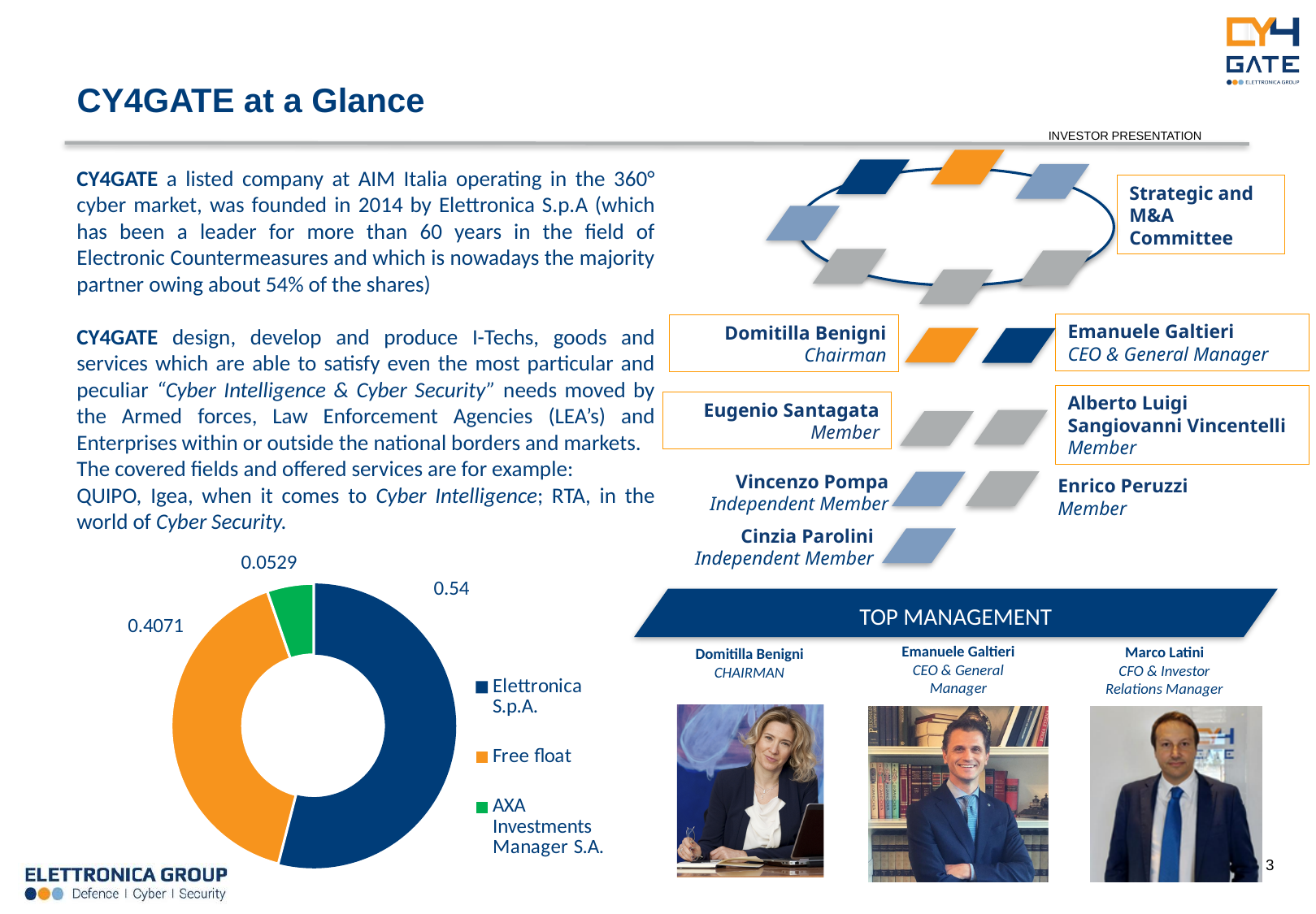
How many slices does the donut chart have? 3 Which is larger in the donut chart, Free float or AXA Investments Manager S.A.? Free float What kind of chart is shown on the slide? Donut (pie) chart What is the value shown for AXA Investments Manager S.A. in the donut chart? 0.0529 Which shareholder has the largest slice in the donut chart? Elettronica S.p.A. How many entries does the legend of the donut chart list? 3 Which shareholder has the smallest slice in the donut chart? AXA Investments Manager S.A. What is the value shown for Elettronica S.p.A. in the donut chart? 0.54 What colour is the AXA Investments Manager S.A. slice in the donut chart? Green What colour is the Free float slice in the donut chart? Orange What is the value shown for Free float in the donut chart? 0.4071 What is the difference between the Elettronica S.p.A. value and the Free float value in the donut chart? 0.1329